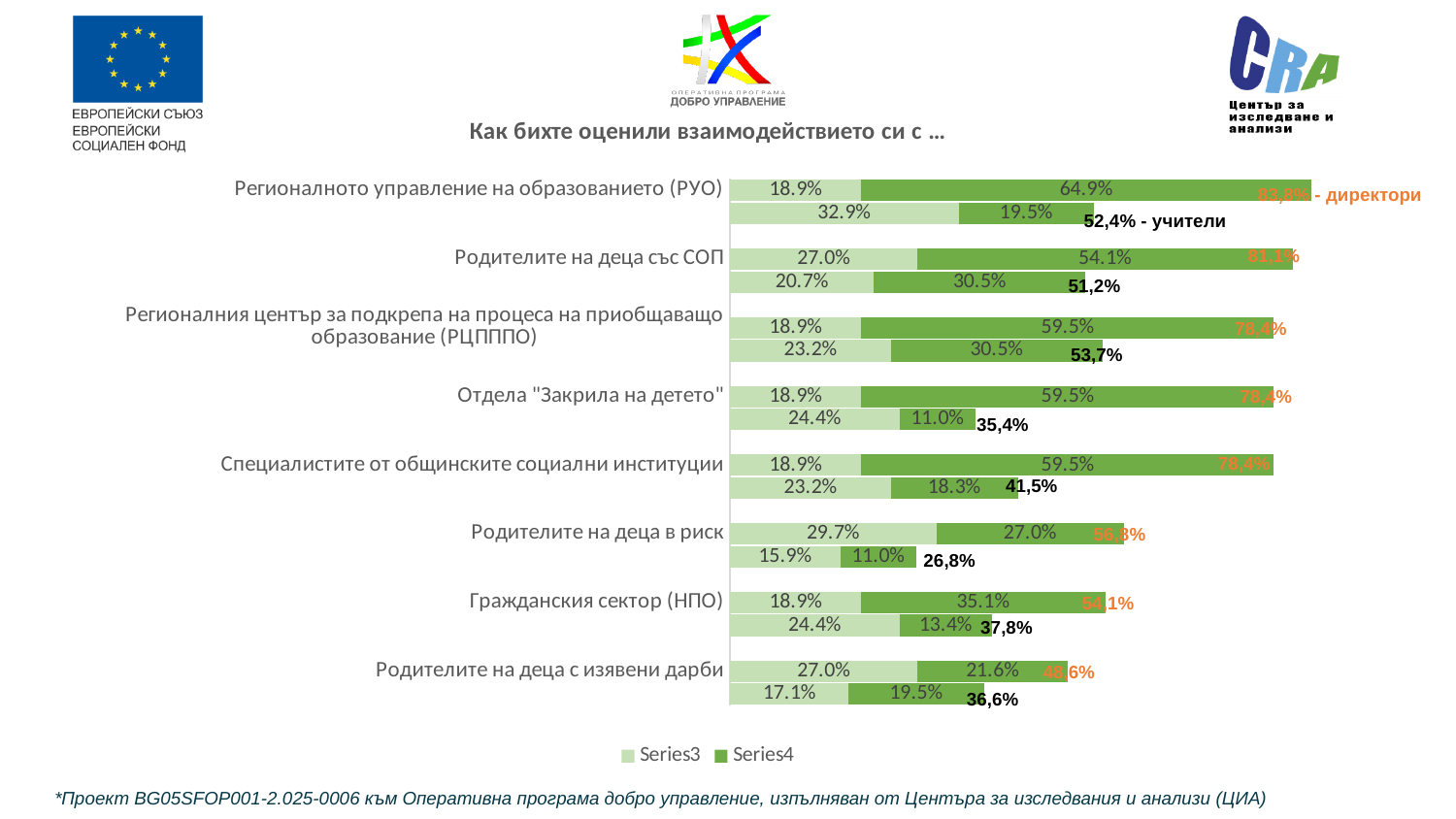
What is the Series3 value in the teachers' bar for Родителите на деца със СОП? 20.7% What is the difference between the directors' total (83,8%) and the teachers' total (52,4%) for Регионалното управление на образованието (РУО)? 31,4% What kind of chart is shown on the slide? Bar chart For Родителите на деца с изявени дарби, which is larger: the directors' total or the teachers' total? The directors' total (48,6%) What is the Series4 value in the directors' bar for Регионалното управление на образованието (РУО)? 64.9% What total is printed at the end of the teachers' bar for Отдела "Закрила на детето"? 35,4% Which category has the lowest total for teachers? Родителите на деца в риск How many series does the chart legend list? 2 How many categories (institutions/groups) are listed on the vertical axis of the chart? 8 Which category has the highest total for directors? Регионалното управление на образованието (РУО) What are the two legend entries shown below the chart? Series3 and Series4 What is the total of the directors' stacked bar for Гражданския сектор (НПО)? 54,1%